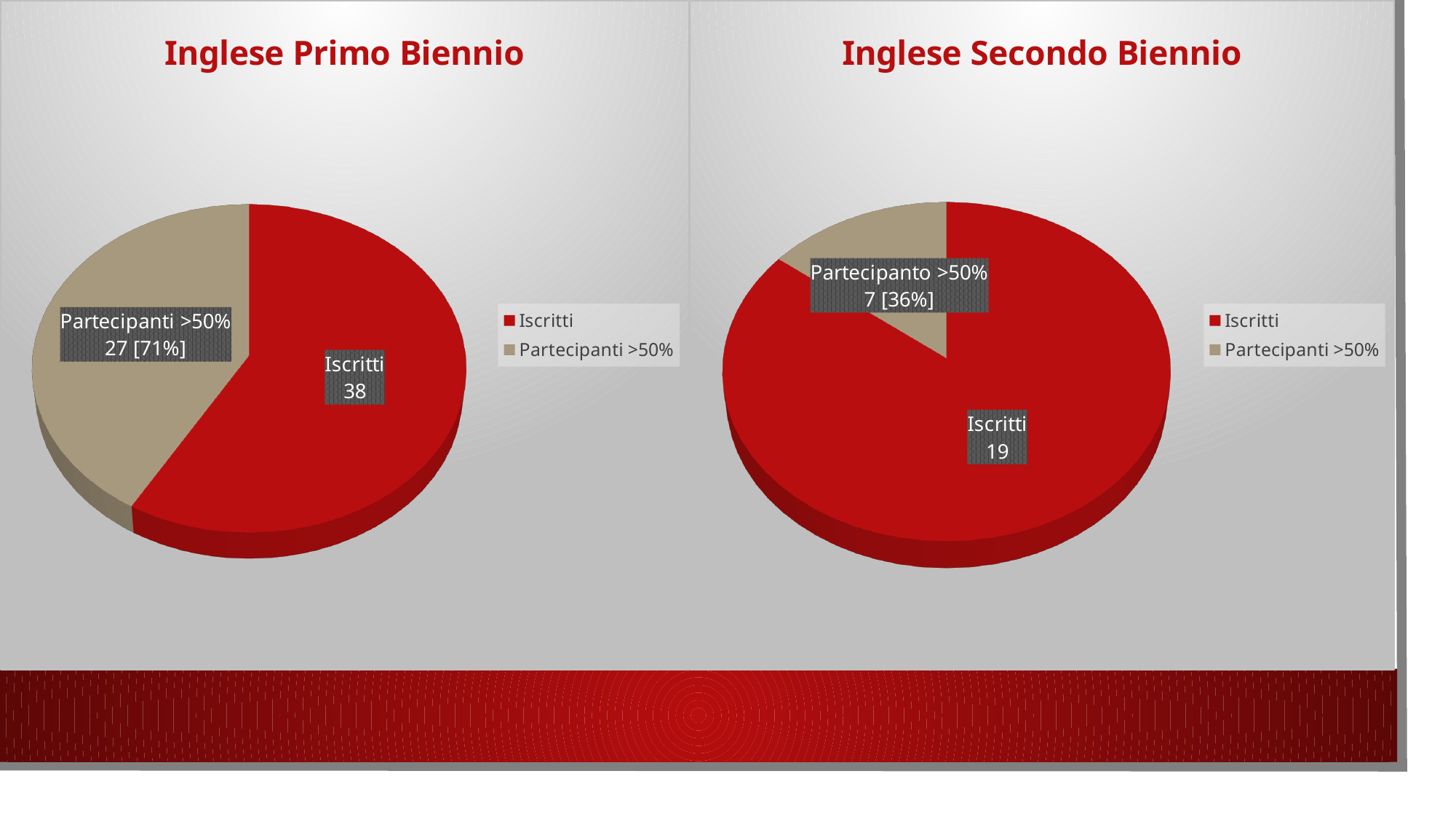
How many entries does the legend of the 'Inglese Secondo Biennio' chart list? 2 In the 'Inglese Primo Biennio' chart, what is the data label shown for the Partecipanti >50% slice? 27 [71%] In the 'Inglese Secondo Biennio' chart, what is the value for Iscritti? 19 How many slices does the 'Inglese Primo Biennio' pie chart have? 2 In the 'Inglese Secondo Biennio' chart, which slice is the smallest? Partecipanto >50% In the 'Inglese Primo Biennio' chart, what is the value for Iscritti? 38 Which chart has the higher Iscritti value, 'Inglese Primo Biennio' or 'Inglese Secondo Biennio'? Inglese Primo Biennio In the 'Inglese Secondo Biennio' chart, what is the data label shown for the Partecipanto >50% slice? 7 [36%] In the 'Inglese Primo Biennio' chart, what is the difference between the Iscritti value (38) and the Partecipanti >50% count (27)? 11 What type of chart is 'Inglese Secondo Biennio'? Pie chart In the 'Inglese Secondo Biennio' chart, what is the difference between the Iscritti value (19) and the Partecipanto >50% count (7)? 12 In the 'Inglese Primo Biennio' chart, which slice is larger, Iscritti or Partecipanti >50%? Iscritti